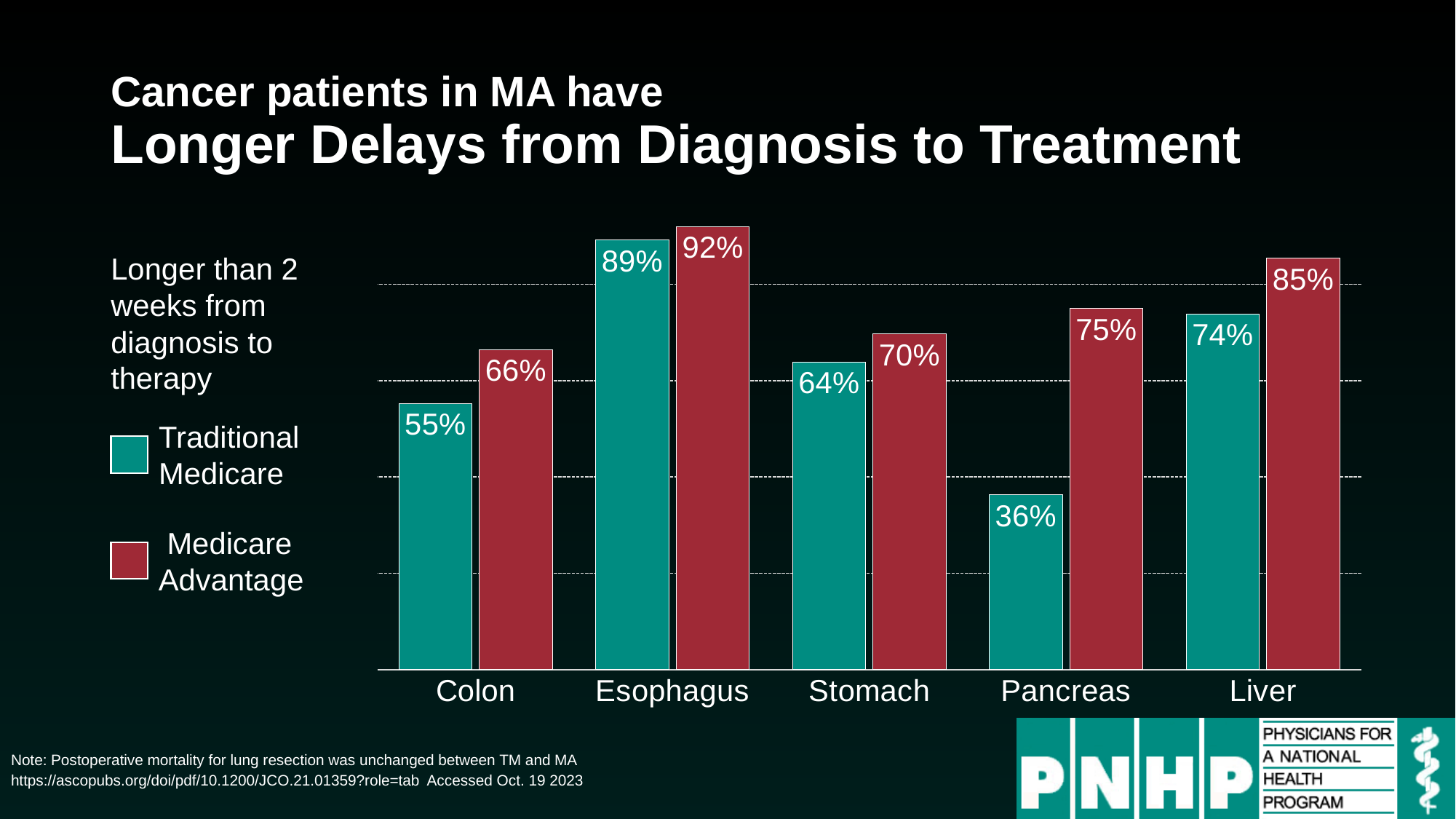
What kind of chart is shown on the slide? Bar chart How many cancer types are shown on the x axis? 5 What is the Traditional Medicare value for Colon? 55% Which cancer type has the highest Medicare Advantage value? Esophagus Which colour represents Medicare Advantage in the chart? Red How many series does the legend list? 2 Which cancer type has the lowest Traditional Medicare value? Pancreas What is the difference between the Medicare Advantage and Traditional Medicare values for Colon? 11% Which is larger for Stomach: the Traditional Medicare value or the Medicare Advantage value? Medicare Advantage What is the difference between the Medicare Advantage and Traditional Medicare values for Pancreas? 39% What is the Medicare Advantage value for Pancreas? 75% What is the Traditional Medicare value for Liver? 74%